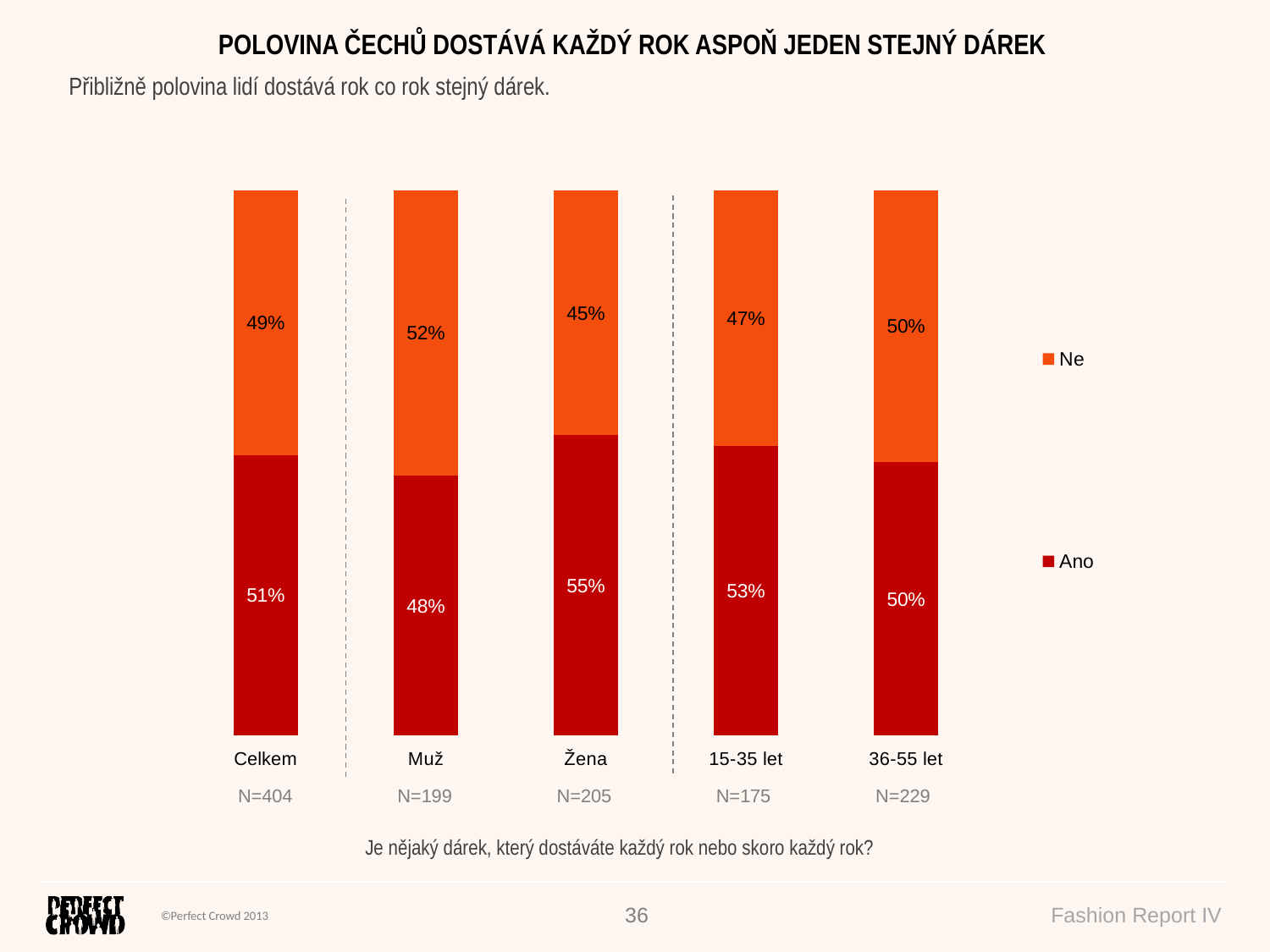
How many categories are shown on the x axis? 5 What kind of chart is shown? Stacked bar chart What is the total of the stacked bar for 36-55 let? 100% What is the 'Ano' value for Žena? 55% What is the 'Ne' value for 15-35 let? 47% Which is larger, the 'Ano' value for 15-35 let or for 36-55 let? 15-35 let What is the 'Ne' value for Muž? 52% What is the 'Ano' value for Celkem? 51% How many series does the legend list? 2 Which category has the lowest 'Ano' value? Muž What is the difference between the 'Ano' values for Žena and Muž? 7% Which category has the highest 'Ano' value? Žena